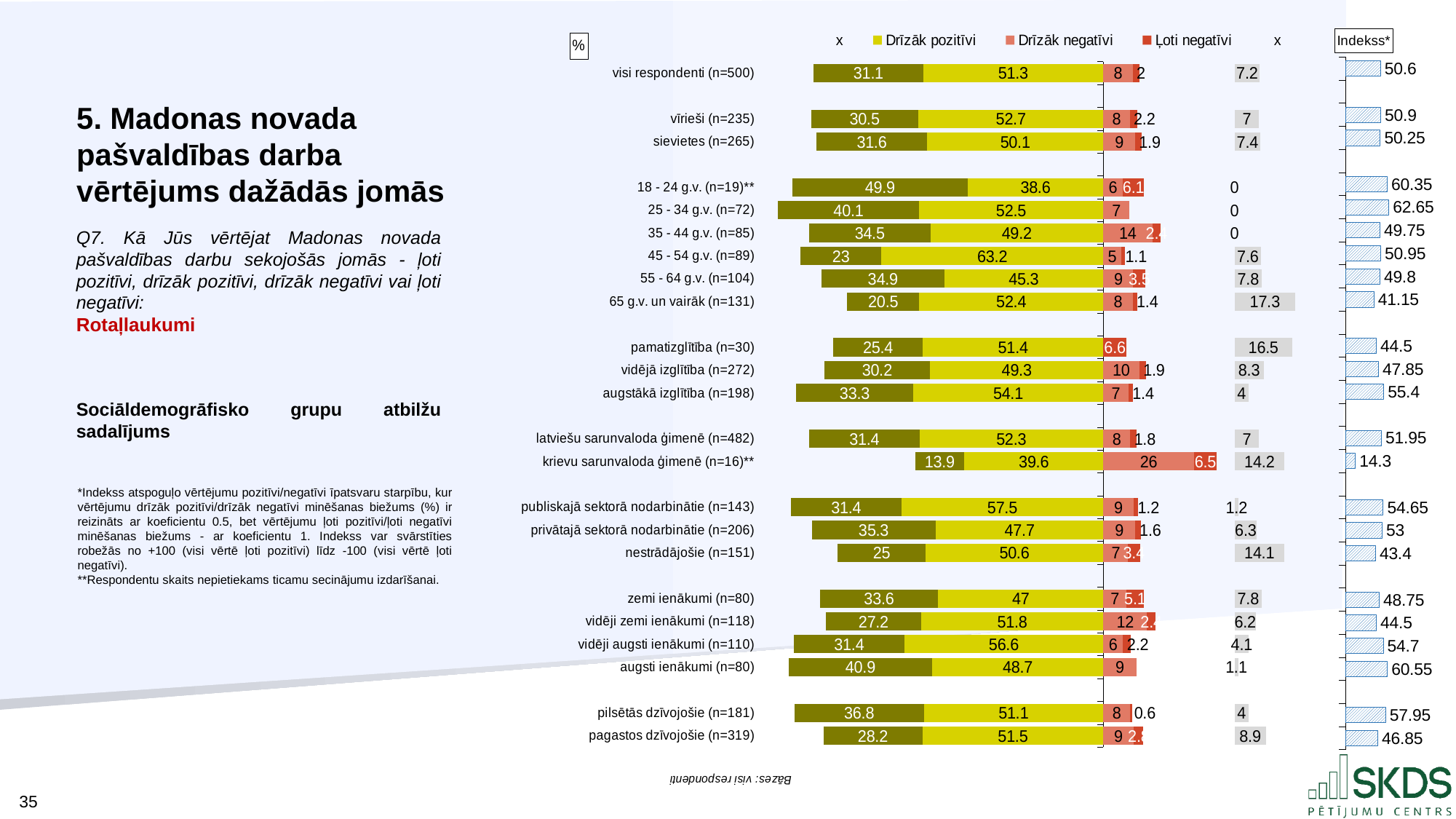
What kind of chart is used to show the response distribution? Stacked bar chart What is the Indekss value for 'augsti ienākumi (n=80)'? 60.55 Which has a higher Indekss value: 'publiskajā sektorā nodarbinātie (n=143)' or 'privātajā sektorā nodarbinātie (n=206)'? publiskajā sektorā nodarbinātie (n=143) What is the Indekss value for '25 - 34 g.v. (n=72)'? 62.65 Which group has the highest 'Drīzāk pozitīvi' value? 45 - 54 g.v. (n=89) What is the 'Drīzāk negatīvi' value for 'krievu sarunvaloda ģimenē (n=16)**'? 26 Which has a higher 'Drīzāk pozitīvi' value: 'vīrieši (n=235)' or 'sievietes (n=265)'? vīrieši (n=235) What is the difference between the Indekss values for 'pilsētās dzīvojošie (n=181)' and 'pagastos dzīvojošie (n=319)'? 11.1 How many respondent groups are shown in the chart? 23 What is the 'Drīzāk pozitīvi' value for 'visi respondenti (n=500)'? 51.3 Which group has the lowest Indekss value? krievu sarunvaloda ģimenē (n=16)** Which group has the highest Indekss value? 25 - 34 g.v. (n=72)